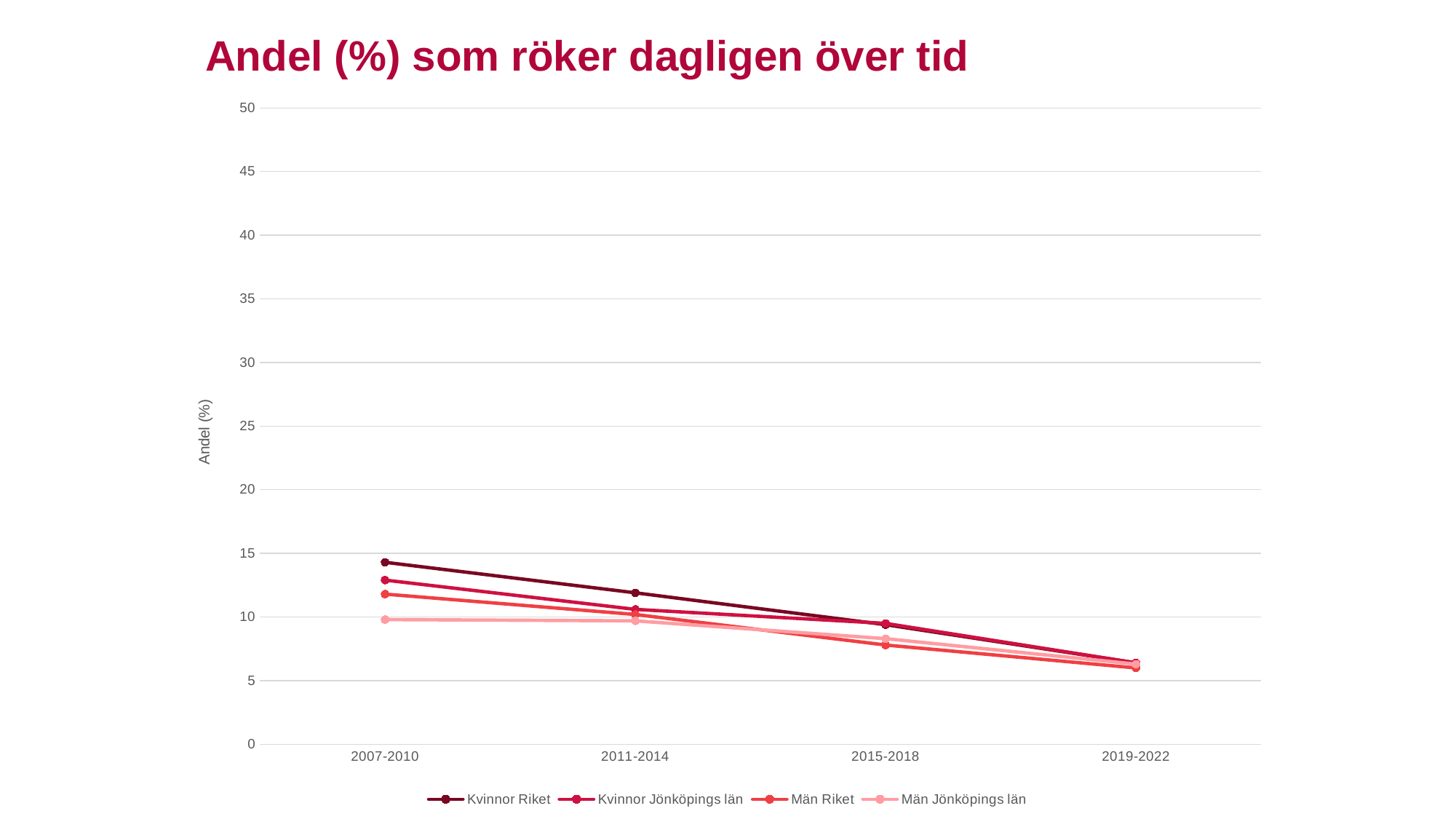
Do the values for Kvinnor Riket rise or fall from 2007-2010 to 2019-2022? fall What kind of chart is shown on the slide? line chart Which series has the highest value in 2007-2010? Kvinnor Riket Is the value for Män Riket in 2019-2022 greater or less than 10? less How many series does the legend list? 4 Which series has the lowest value in 2007-2010? Män Jönköpings län What is the label on the y axis? Andel (%) What is the title of the chart? Andel (%) som röker dagligen över tid How many time periods are shown on the x axis? 4 In 2015-2018, which is larger: the value for Kvinnor Riket or the value for Män Riket? Kvinnor Riket Is the value for Kvinnor Riket in 2007-2010 greater or less than 10? greater